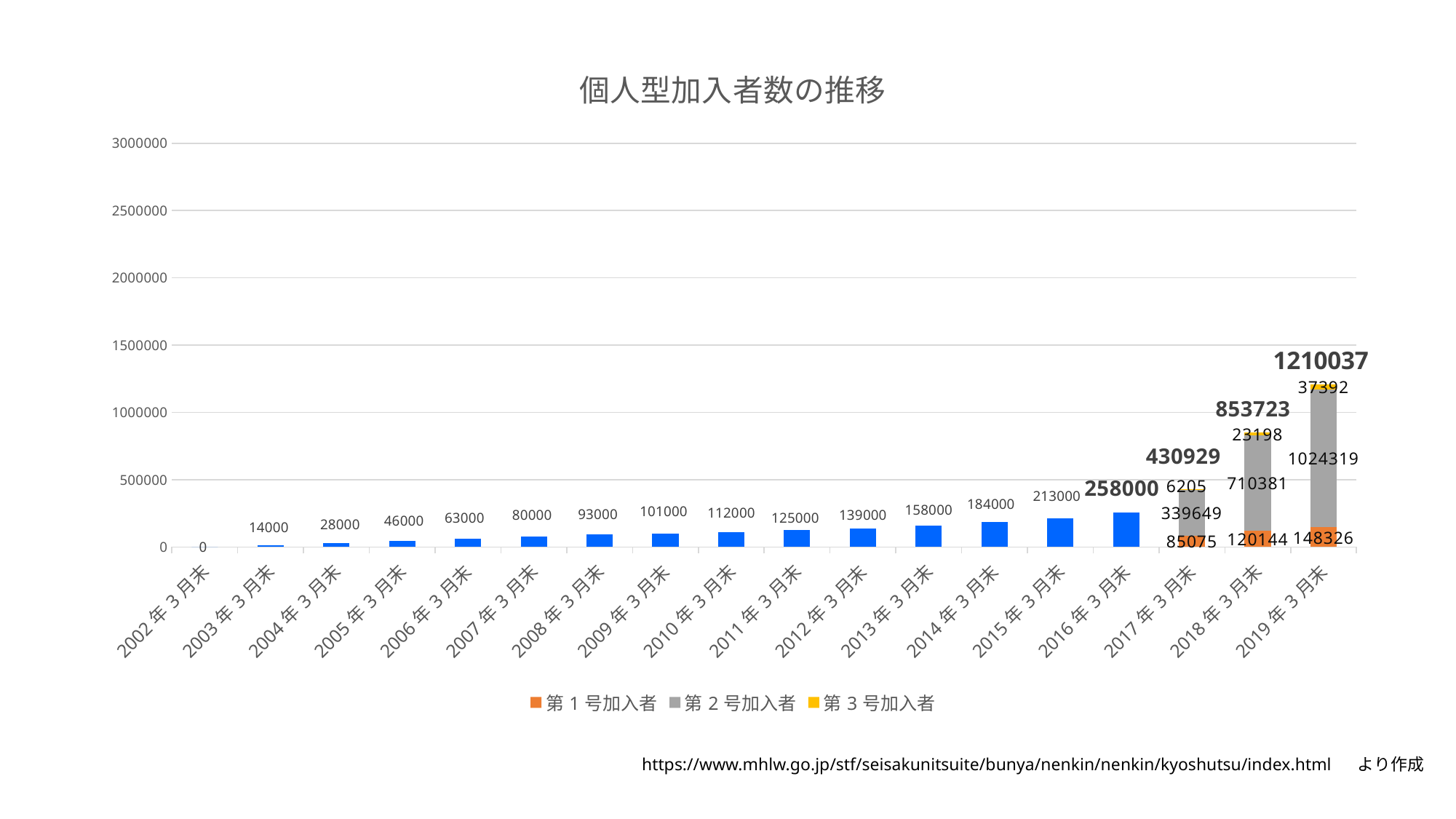
Do the values generally rise or fall from 2002年3月末 to 2019年3月末? rise How many series does the legend list? 3 What is the value of 第3号加入者 for 2019年3月末? 37392 What is the difference between the values for 2016年3月末 and 2015年3月末? 45000 What type of chart is shown on the slide? Stacked bar chart What is the value labelled for 2010年3月末? 112000 What is the total labelled above the stacked bar for 2017年3月末? 430929 What is the value of 第2号加入者 for 2018年3月末? 710381 Which year has the highest total value? 2019年3月末 Is the total for 2019年3月末 greater or less than 1000000? greater How many year categories are shown on the x axis? 18 What is the title of the chart? 個人型加入者数の推移